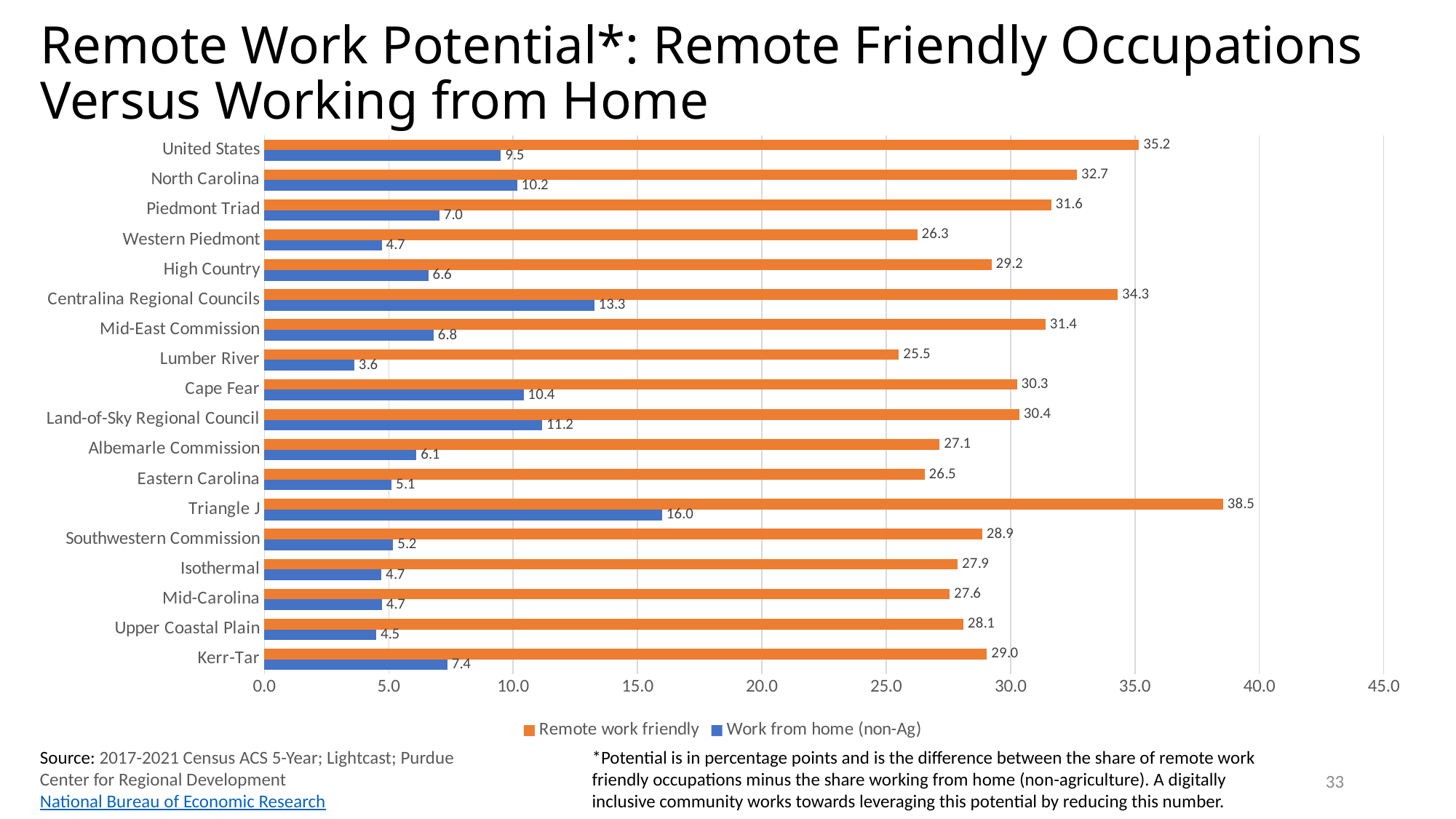
What is the Remote work friendly value for Triangle J? 38.5 Which is larger: the Work from home (non-Ag) value for North Carolina or for Cape Fear? Cape Fear What is the Work from home (non-Ag) value for Centralina Regional Councils? 13.3 Which category has the lowest Remote work friendly value? Lumber River What is the Remote work friendly value for the United States? 35.2 How many categories are shown on the chart? 18 Is the Remote work friendly value for Western Piedmont greater or less than 30.0? less What is the difference between the Remote work friendly and Work from home (non-Ag) values for Triangle J? 22.5 Which category has the lowest Work from home (non-Ag) value? Lumber River Which category has the highest Remote work friendly value? Triangle J What kind of chart is shown on the slide? Bar chart How many series does the legend list? 2